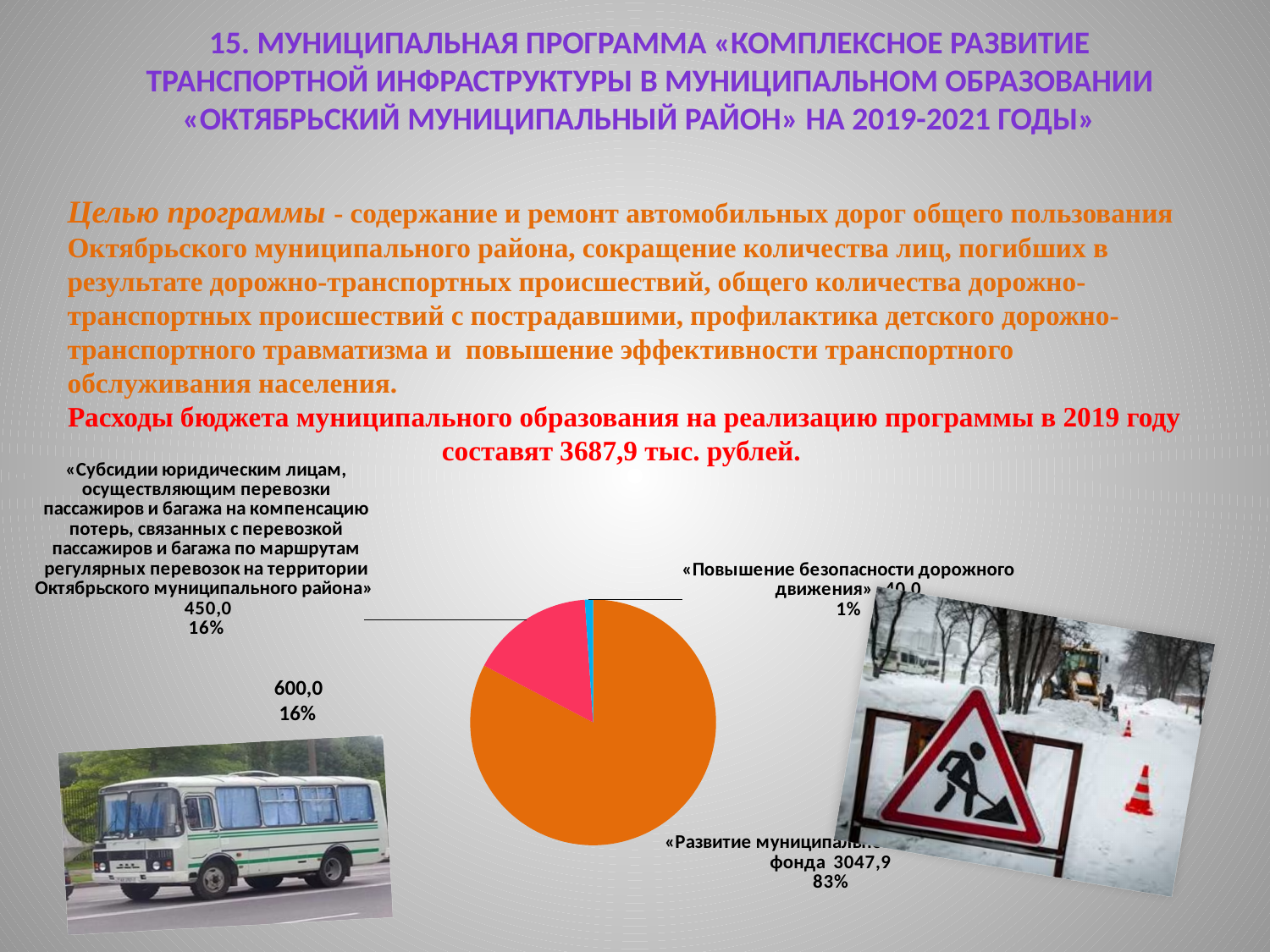
What share of the pie does the slice «Повышение безопасности дорожного движения» represent? 1% What colour is the largest slice of the pie chart? orange What value is shown for the slice «Повышение безопасности дорожного движения»? 40,0 What kind of chart is shown on the slide? pie chart What share of the pie does the slice «Развитие муниципального дорожного фонда» represent? 83% What value is shown for the slice «Развитие муниципального дорожного фонда»? 3047,9 Which slice of the pie chart is the smallest? «Повышение безопасности дорожного движения» Which slice of the pie chart is the largest? «Развитие муниципального дорожного фонда» How many slices does the pie chart have? 3